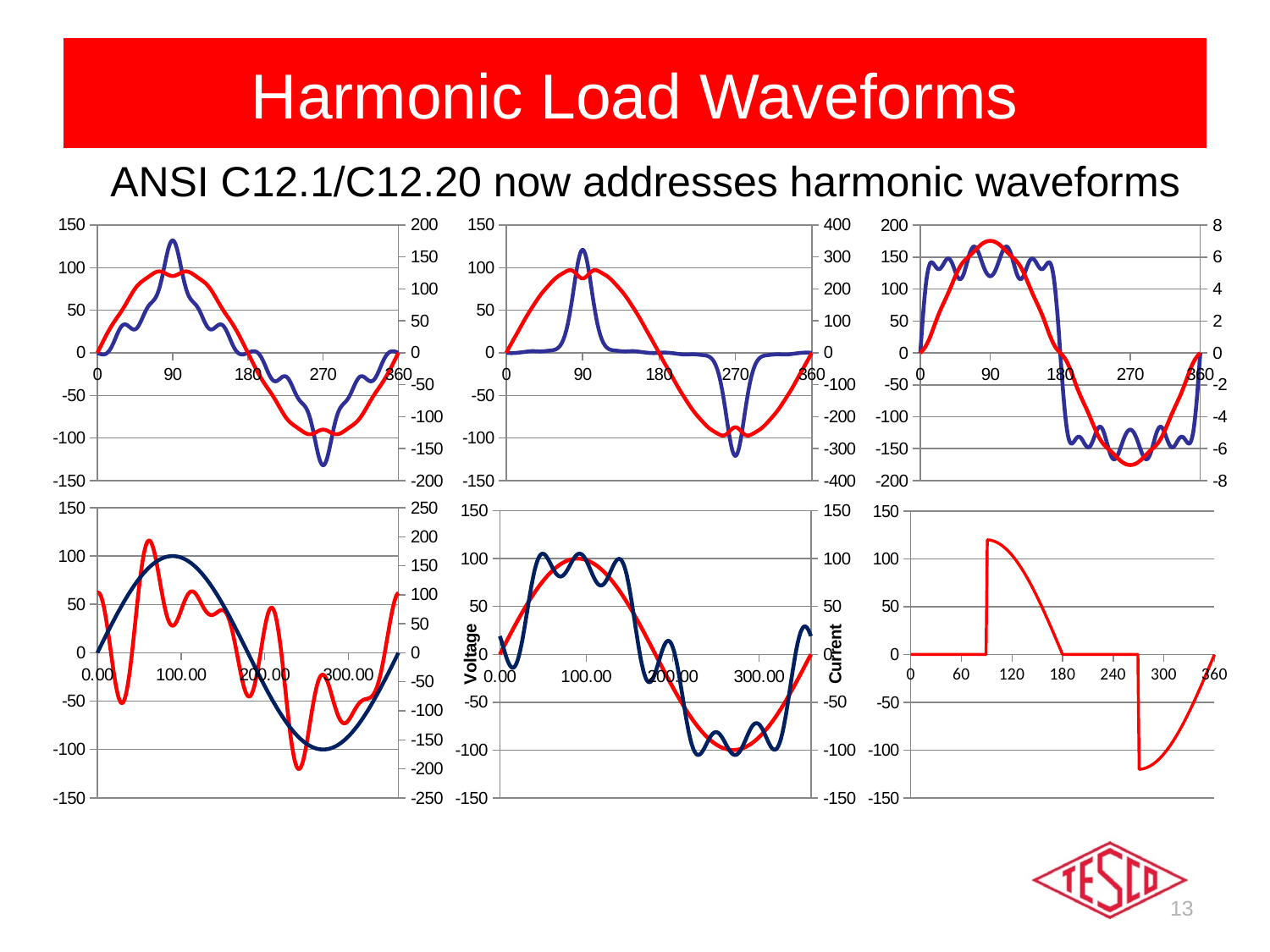
In the bottom-right chart, does the red line rise or fall between x = 300 and x = 360? rise How many charts are shown on the slide? 6 In the bottom-right chart, what is the value of the red line at x = 30? 0 What kind of chart is the top-left chart on the slide? line chart In the bottom-right chart, is the peak value of the red line just after x = 90 greater or less than 100? greater In the bottom-middle chart, what is the title of the left vertical axis? Voltage In the bottom-middle chart, what is the title of the right vertical axis? Current In the bottom-right chart, does the red line rise or fall between x = 120 and x = 180? fall In the bottom-right chart, what is the value of the red line at x = 240? 0 How many lines are plotted in the top-middle chart? 2 In the bottom-middle chart, is the value of the red line at x = 100.00 greater or less than 50? greater In the bottom-right chart, is the value of the red line just after x = 270 greater or less than -100? less